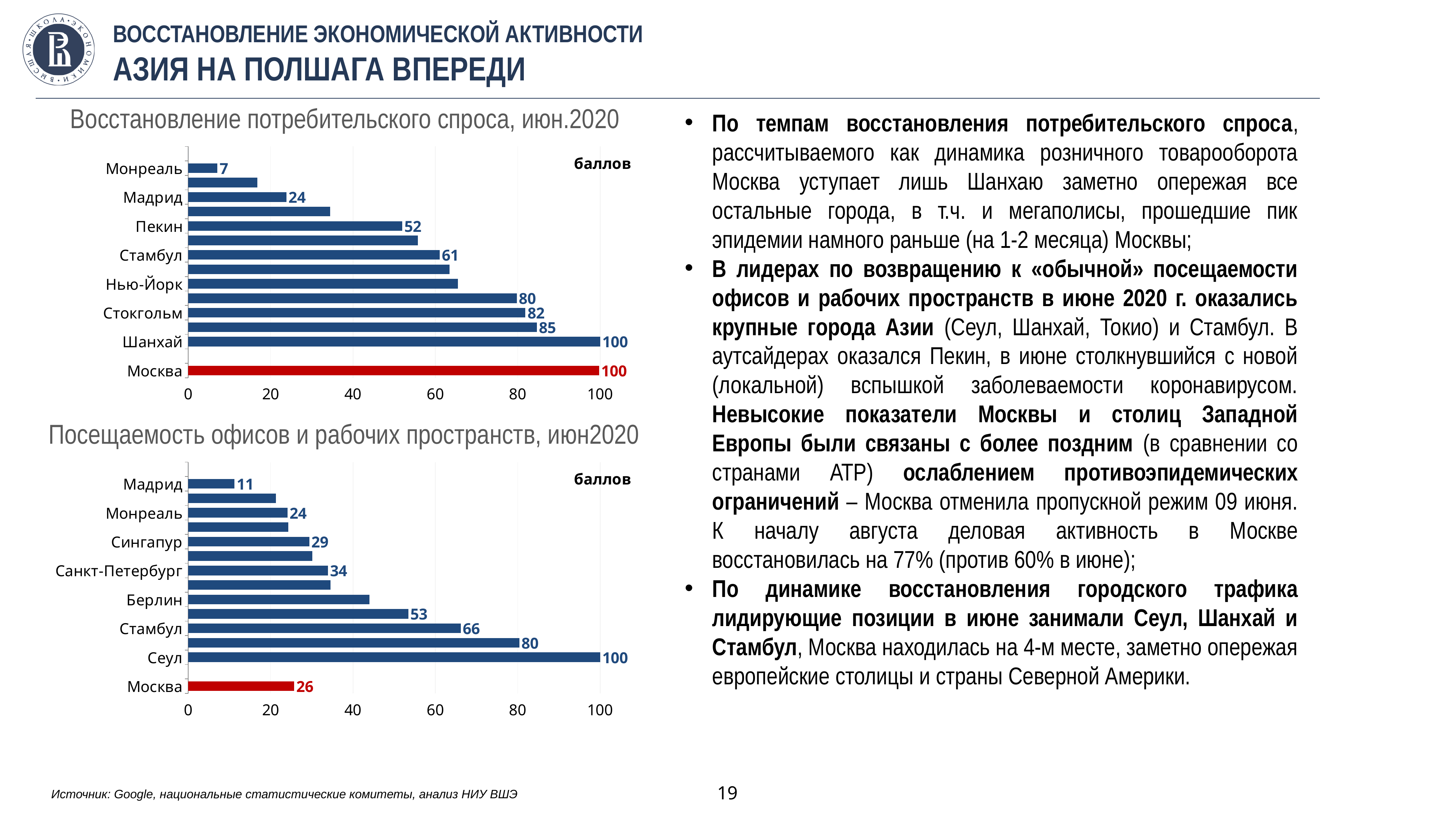
In the chart 'Восстановление потребительского спроса, июн.2020', is the value for Нью-Йорк greater or less than 60? greater What type of chart is 'Посещаемость офисов и рабочих пространств, июн2020'? bar chart In the chart 'Восстановление потребительского спроса, июн.2020', what is the value for Пекин? 52 In the chart 'Восстановление потребительского спроса, июн.2020', what is the value for Москва? 100 In the chart 'Посещаемость офисов и рабочих пространств, июн2020', what is the difference between the values for Сеул and Москва? 74 In the chart 'Посещаемость офисов и рабочих пространств, июн2020', is the value for Берлин greater or less than 60? less In the chart 'Посещаемость офисов и рабочих пространств, июн2020', which city has the lowest value? Мадрид In the chart 'Восстановление потребительского спроса, июн.2020', which labeled city has the lowest value? Монреаль In the chart 'Восстановление потребительского спроса, июн.2020', what is the difference between the values for Стокгольм and Мадрид? 58 In the chart 'Восстановление потребительского спроса, июн.2020', which is larger: the value for Стамбул or for Пекин? Стамбул In the chart 'Посещаемость офисов и рабочих пространств, июн2020', which city has the highest value? Сеул In the chart 'Посещаемость офисов и рабочих пространств, июн2020', what is the value for Москва? 26